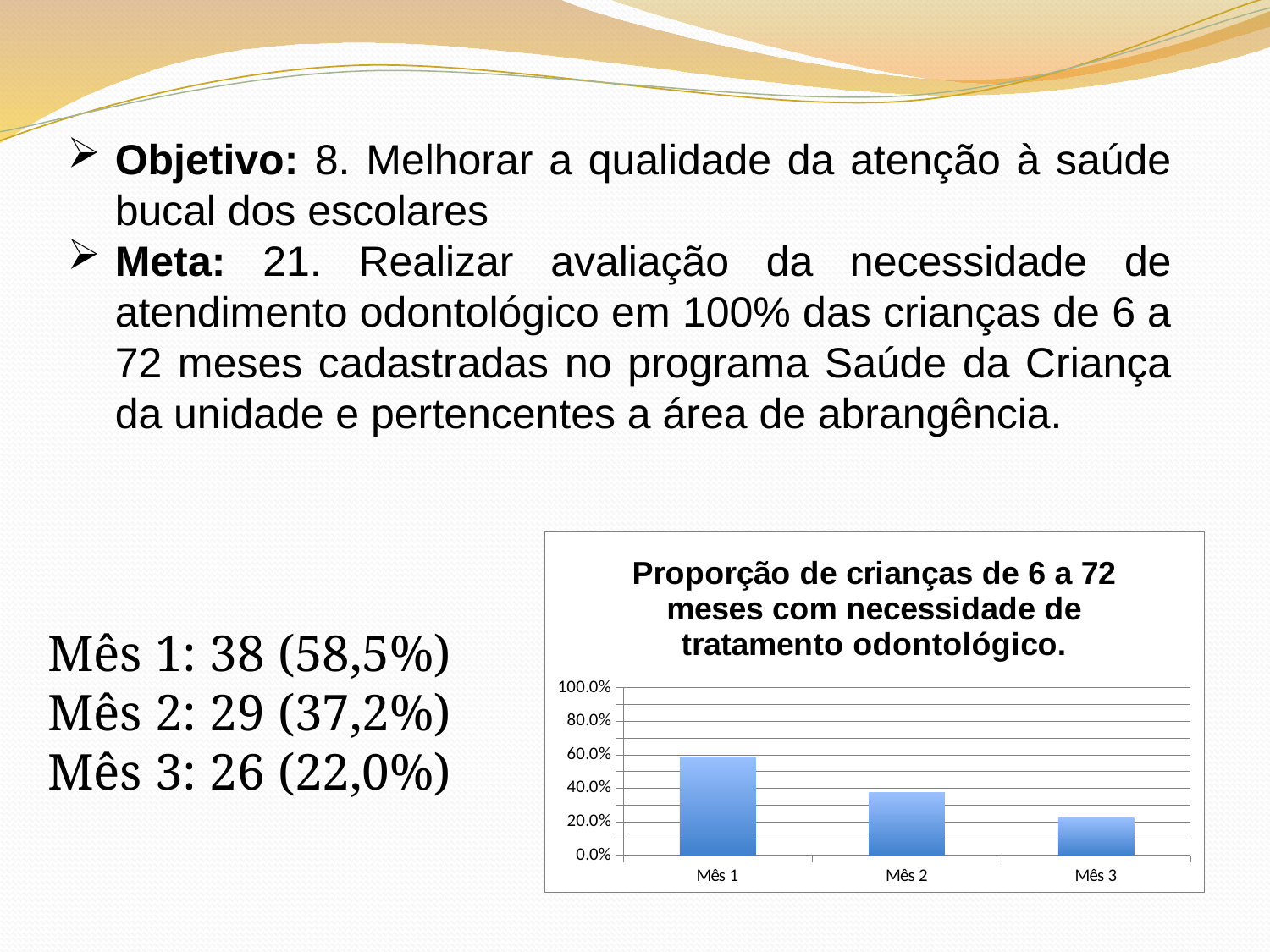
What is the title of the chart? Proporção de crianças de 6 a 72 meses com necessidade de tratamento odontológico. Which month has the highest bar in the chart? Mês 1 According to the slide, what proportion is shown for Mês 1? 58,5% Is the value for Mês 2 greater or less than 40.0%? less According to the slide, what proportion is shown for Mês 3? 22,0% Is the value for Mês 3 greater or less than 20.0%? greater Which month has the lowest bar in the chart? Mês 3 Do the values rise or fall from Mês 1 to Mês 3? fall How many categories are plotted on the x axis of the chart? 3 Which is larger, the value for Mês 2 or the value for Mês 3? Mês 2 What kind of chart is shown on the slide? bar chart Is the value for Mês 1 greater or less than 40.0%? greater